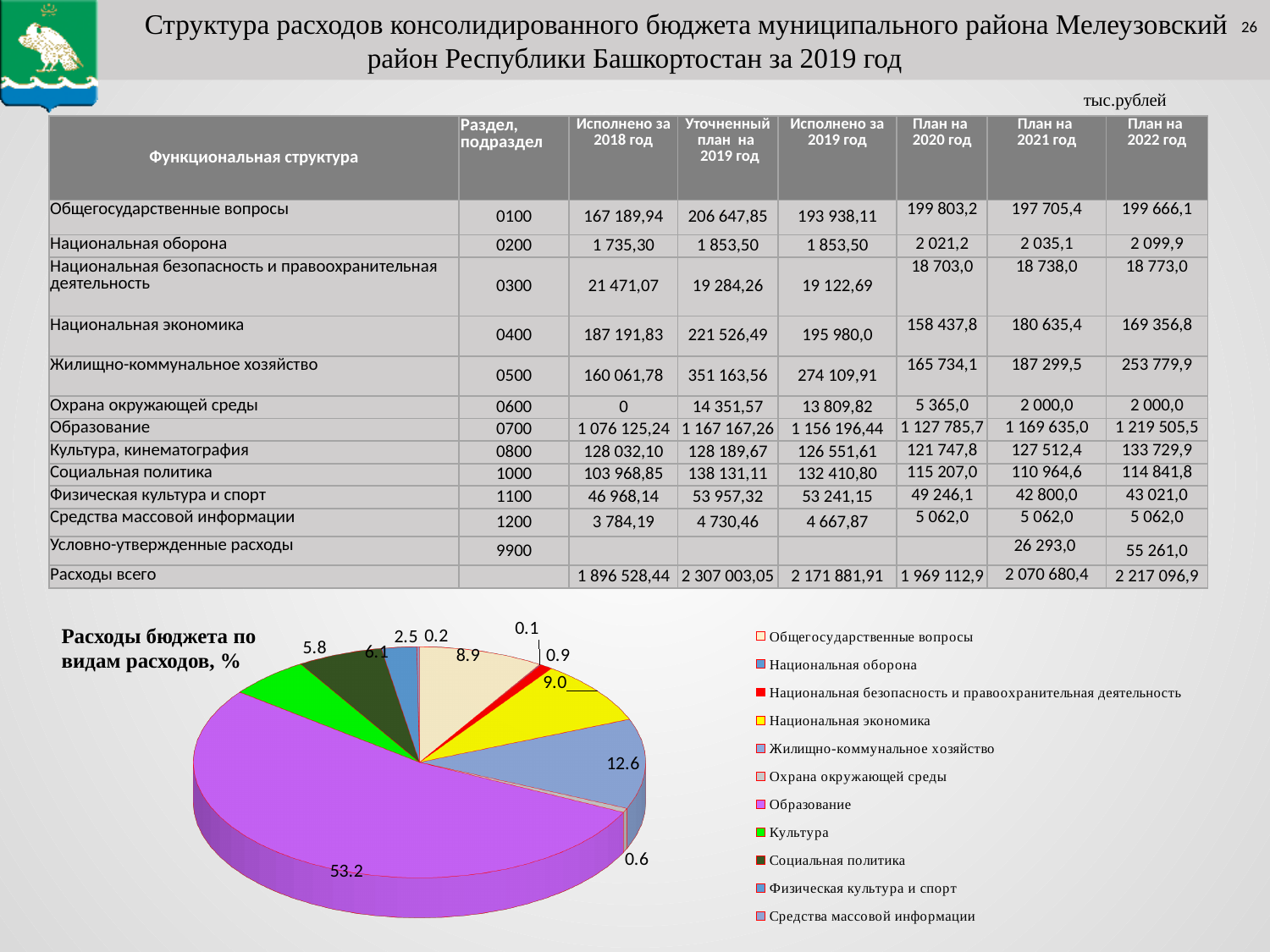
What is the share of Культура in the pie chart? 5.8 By how many percentage points does the share of Образование exceed the share of Жилищно-коммунальное хозяйство? 40.6 What is the share of Общегосударственные вопросы in the pie chart? 8.9 What kind of chart is shown on the slide? pie chart What is the share of Национальная экономика in the pie chart? 9.0 What is the share of Образование in the pie chart? 53.2 Which category has the largest share of the pie chart? Образование Which has the larger share in the pie chart, Социальная политика or Культура? Социальная политика What is the share of Социальная политика in the pie chart? 6.1 What is the title of the chart on the slide? Расходы бюджета по видам расходов, % What is the share of Жилищно-коммунальное хозяйство in the pie chart? 12.6 How many categories does the legend of the pie chart list? 11